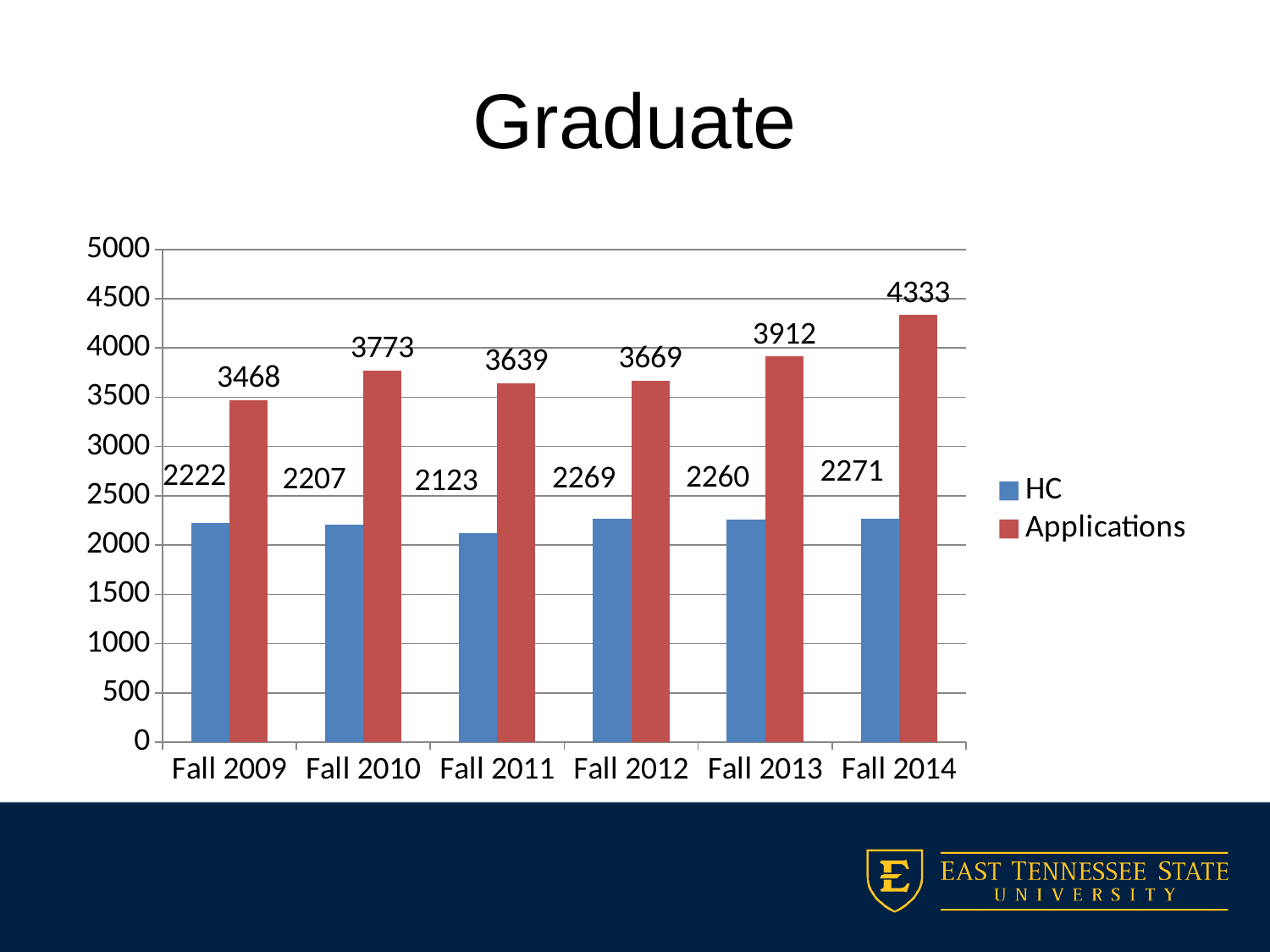
Which is larger, Applications in Fall 2011 or Applications in Fall 2012? Fall 2012 Which term has the highest Applications value? Fall 2014 What is the HC value for Fall 2011? 2123 What is the title of the chart? Graduate What is the difference between Applications and HC in Fall 2014? 2062 How many series does the legend list? 2 What is the difference in Applications between Fall 2010 and Fall 2009? 305 What kind of chart is shown on the slide? bar chart What is the Applications value for Fall 2013? 3912 How many terms are shown on the x axis? 6 Which term has the lowest HC value? Fall 2011 Is the Applications value for Fall 2014 greater or less than 4000? greater